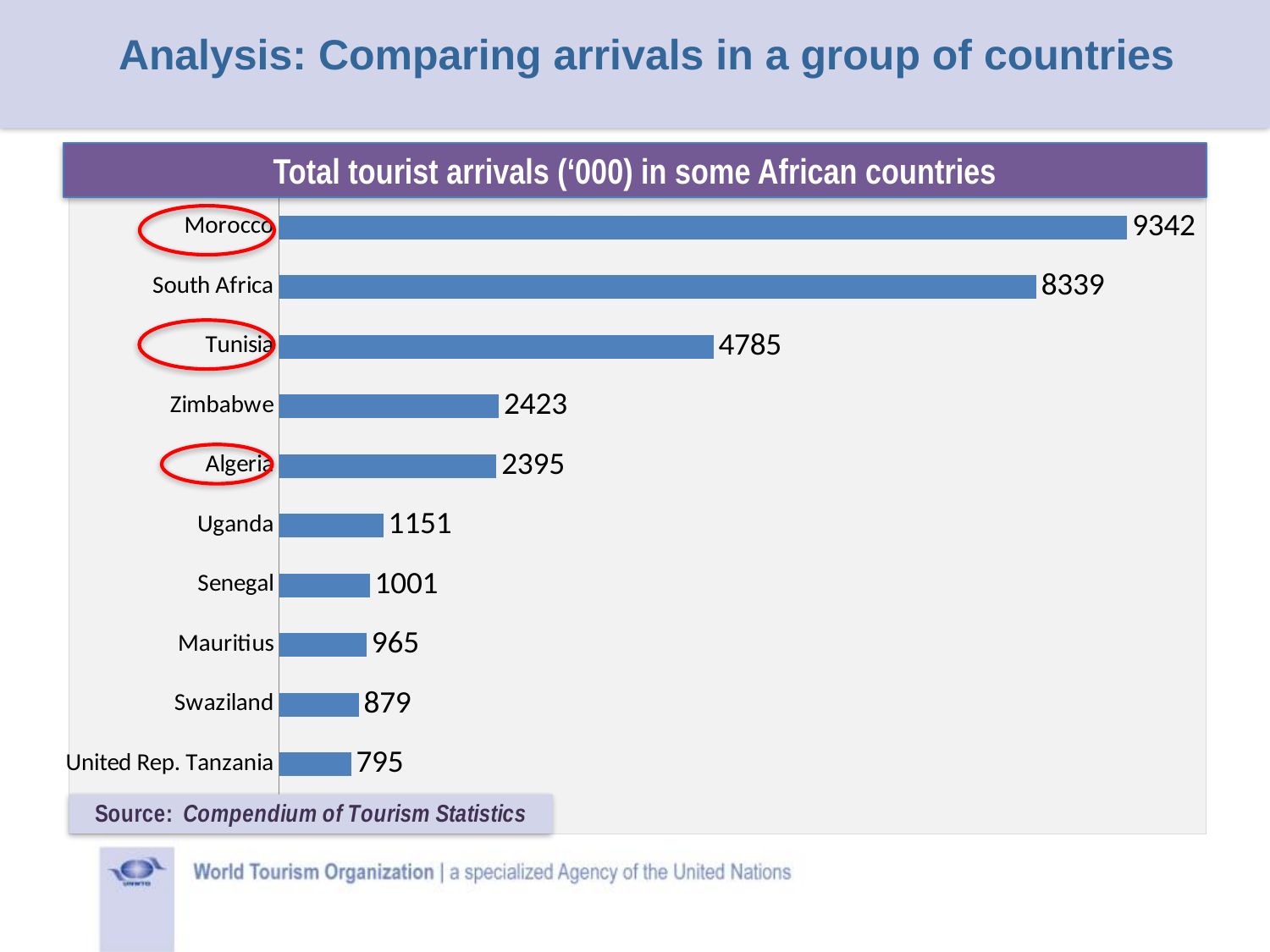
Which is larger, the value for Swaziland or the value for United Rep. Tanzania? Swaziland How many countries are shown in the chart? 10 What kind of chart is shown on the slide? Bar chart What is the title of the chart? Total tourist arrivals ('000) in some African countries Which country has the lowest total tourist arrivals? United Rep. Tanzania What is the difference between the values for Zimbabwe and Algeria? 28 What is the value for Senegal? 1001 Which is larger, the value for Uganda or the value for Mauritius? Uganda What is the value for Tunisia? 4785 What is the value for Morocco? 9342 What is the difference between the values for Morocco and South Africa? 1003 Which country has the highest total tourist arrivals? Morocco